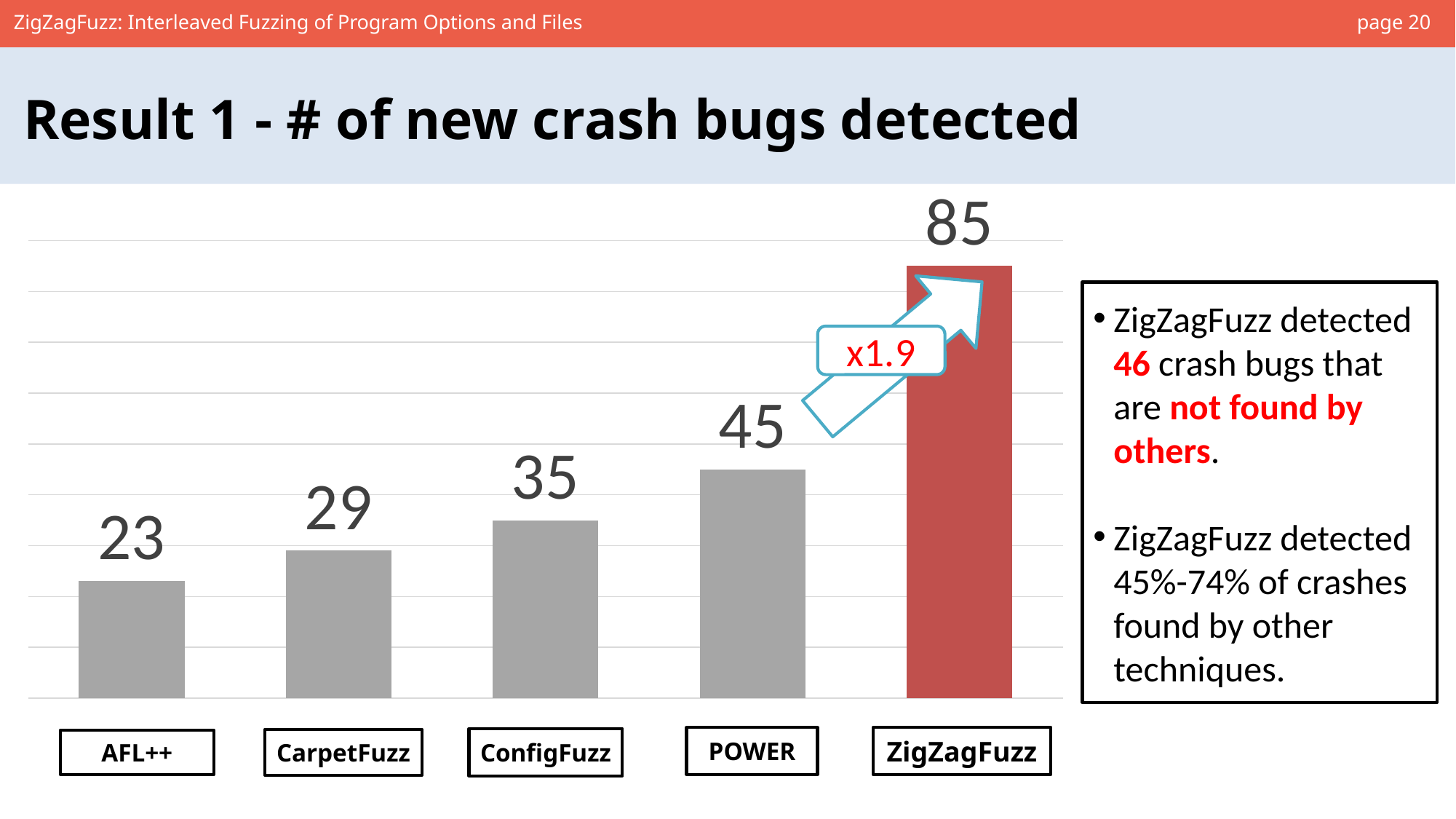
What multiplier is shown in the callout next to the ZigZagFuzz bar? x1.9 Which tool has the highest number of new crash bugs detected? ZigZagFuzz What is the value shown for ConfigFuzz? 35 How many tools (categories) are shown in the chart? 5 Which tool has the lowest number of new crash bugs detected? AFL++ What is the value shown for AFL++? 23 What is the difference between the values for CarpetFuzz and AFL++? 6 How many new crash bugs did ZigZagFuzz detect according to the chart? 85 What kind of chart is shown on the slide? Bar chart What is the value shown for POWER? 45 What is the difference between the values for ZigZagFuzz and POWER? 40 Which has a larger value, ConfigFuzz or CarpetFuzz? ConfigFuzz